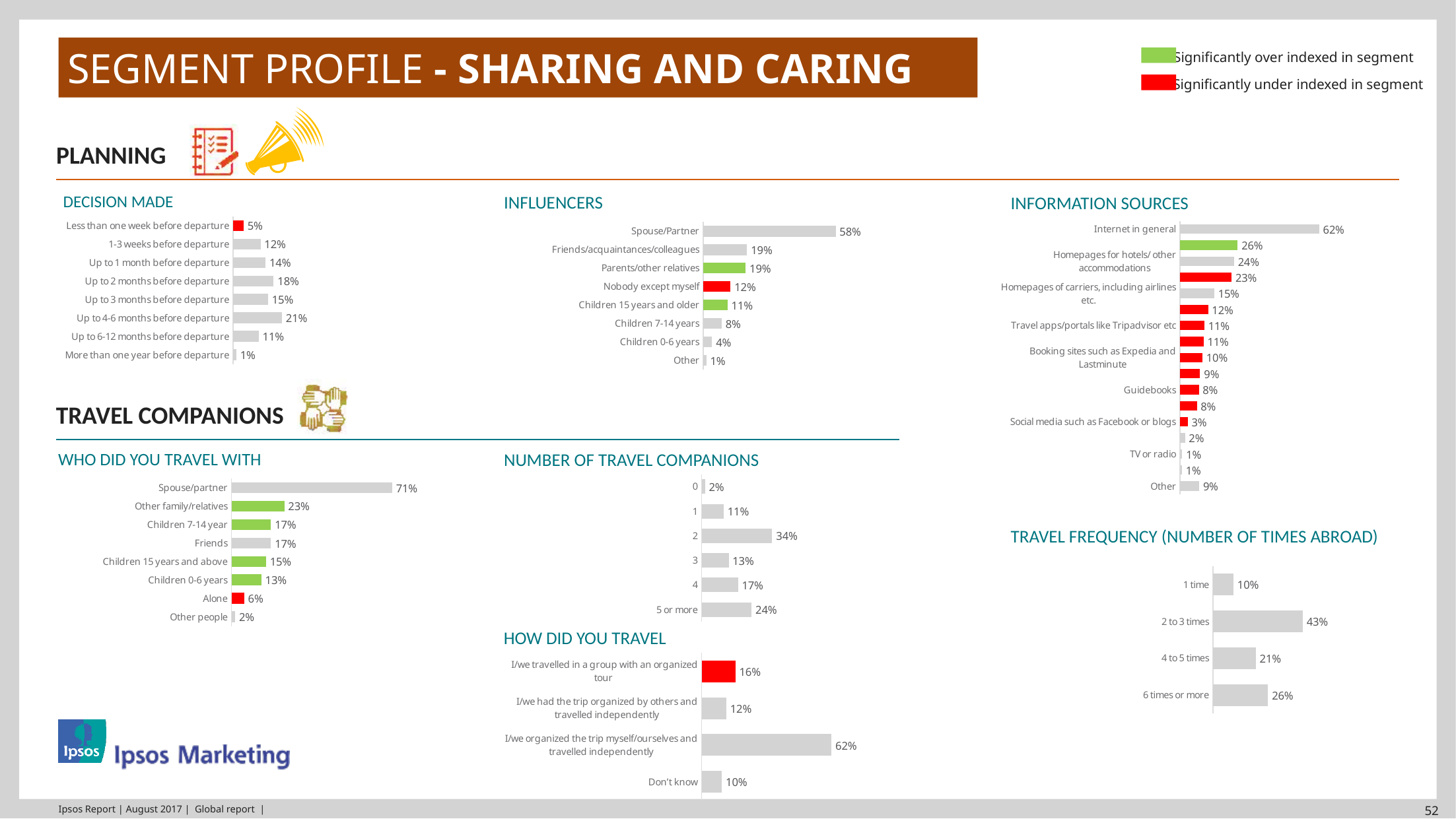
In the Influencers chart, what is the value for Spouse/Partner? 58% In the Who Did You Travel With chart, which category has the highest value? Spouse/partner How many categories are shown in the Number of Travel Companions chart? 6 What type of chart is the Travel Frequency (Number of Times Abroad) chart? Bar chart In the Travel Frequency chart, which category has the highest value? 2 to 3 times In the How Did You Travel chart, what is the value for 'I/we organized the trip myself/ourselves and travelled independently'? 62% In the Number of Travel Companions chart, what is the value for '2'? 34% In the Who Did You Travel With chart, which is larger: Other family/relatives or Alone? Other family/relatives In the Decision Made chart, what is the value for 'Up to 4-6 months before departure'? 21% In the Decision Made chart, which category has the lowest value? More than one year before departure In the Influencers chart, what is the difference between Spouse/Partner and Nobody except myself? 46% In the Information Sources chart, what is the value for 'Internet in general'? 62%